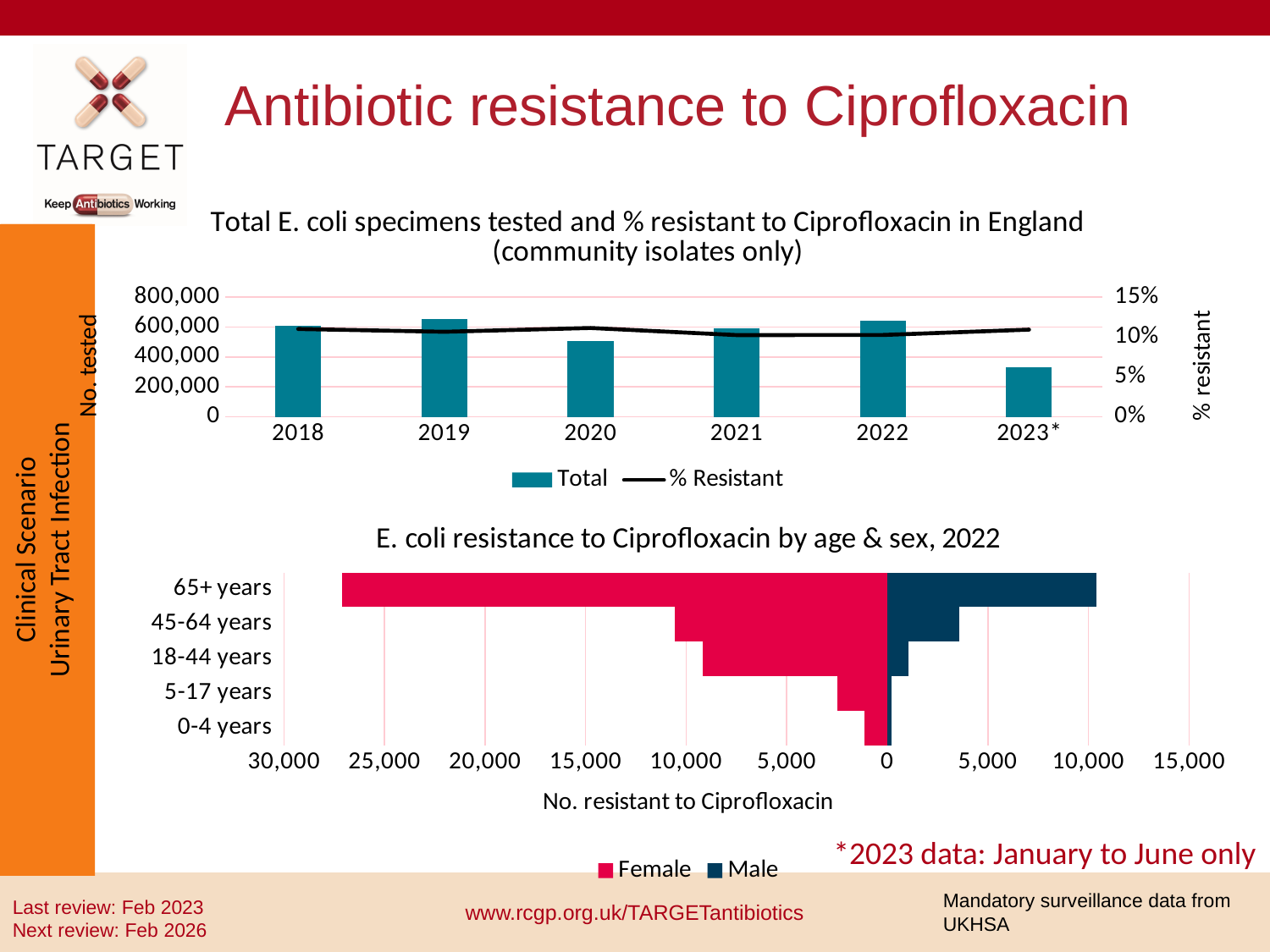
In the top chart, which year has the lowest number tested? 2023* In the top chart, how many series does the legend list? 2 In the top chart, is the number tested in 2020 greater or less than 600,000? less In the top chart, which year has the larger number tested, 2020 or 2021? 2021 In the bottom chart, 'E. coli resistance to Ciprofloxacin by age & sex, 2022', how many age groups are shown? 5 In the top chart, how many years are shown on the x axis? 6 In the bottom chart, is the Male value for 45-64 years greater or less than 5,000? less In the top chart, is the number tested in 2019 greater or less than 600,000? greater In the bottom chart, which age group has the highest number of resistant Female isolates? 65+ years What kind of chart is the top chart, 'Total E. coli specimens tested and % resistant to Ciprofloxacin in England'? Bar chart with a line